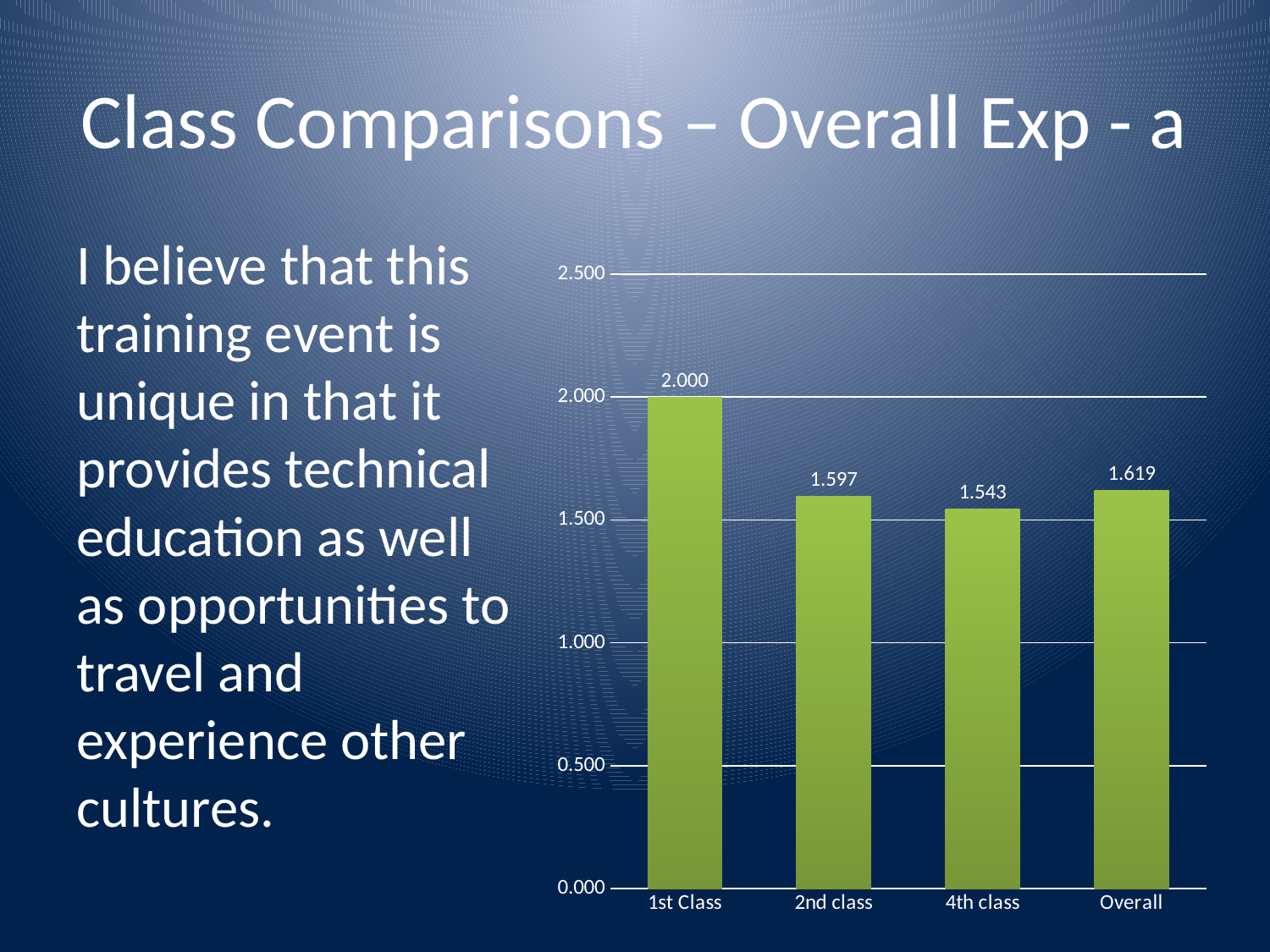
Which category has the lowest value? 4th class How many categories are shown on the x axis? 4 Which is larger, the value for 2nd class or the value for 4th class? 2nd class What is the value for 2nd class? 1.597 What is the value for 4th class? 1.543 What is the difference between the values for 1st Class and 4th class? 0.457 What is the value for Overall? 1.619 Is the value for 4th class greater or less than 1.500? greater What is the value for 1st Class? 2.000 What is the difference between the values for Overall and 2nd class? 0.022 What kind of chart is shown on the slide? bar chart Which category has the highest value? 1st Class